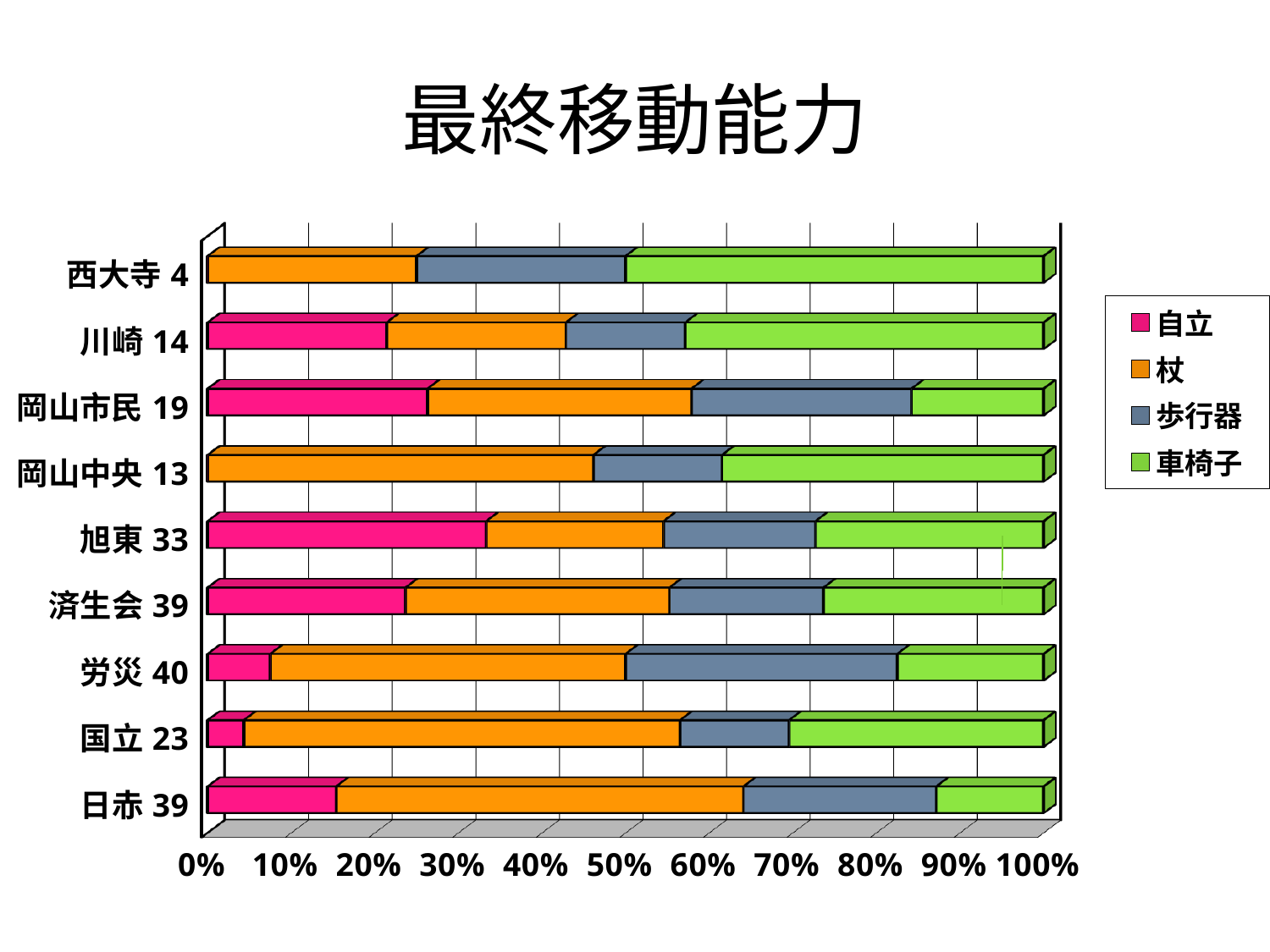
What is the title of the chart? 最終移動能力 How many hospitals (categories) are plotted on the chart? 9 Which hospital has the largest 自立 share? 旭東 33 Is the 自立 share for 岡山市民 19 greater or less than 20%? greater Which has the larger 自立 share, 旭東 33 or 労災 40? 旭東 33 How many series does the legend list? 4 Is the 自立 share for 旭東 33 greater or less than 30%? greater Is the 自立 share for 国立 23 greater or less than 10%? less Which series is shown in green in the legend? 車椅子 Which hospital has the largest 車椅子 share? 西大寺 4 What kind of chart is shown on the slide? bar chart